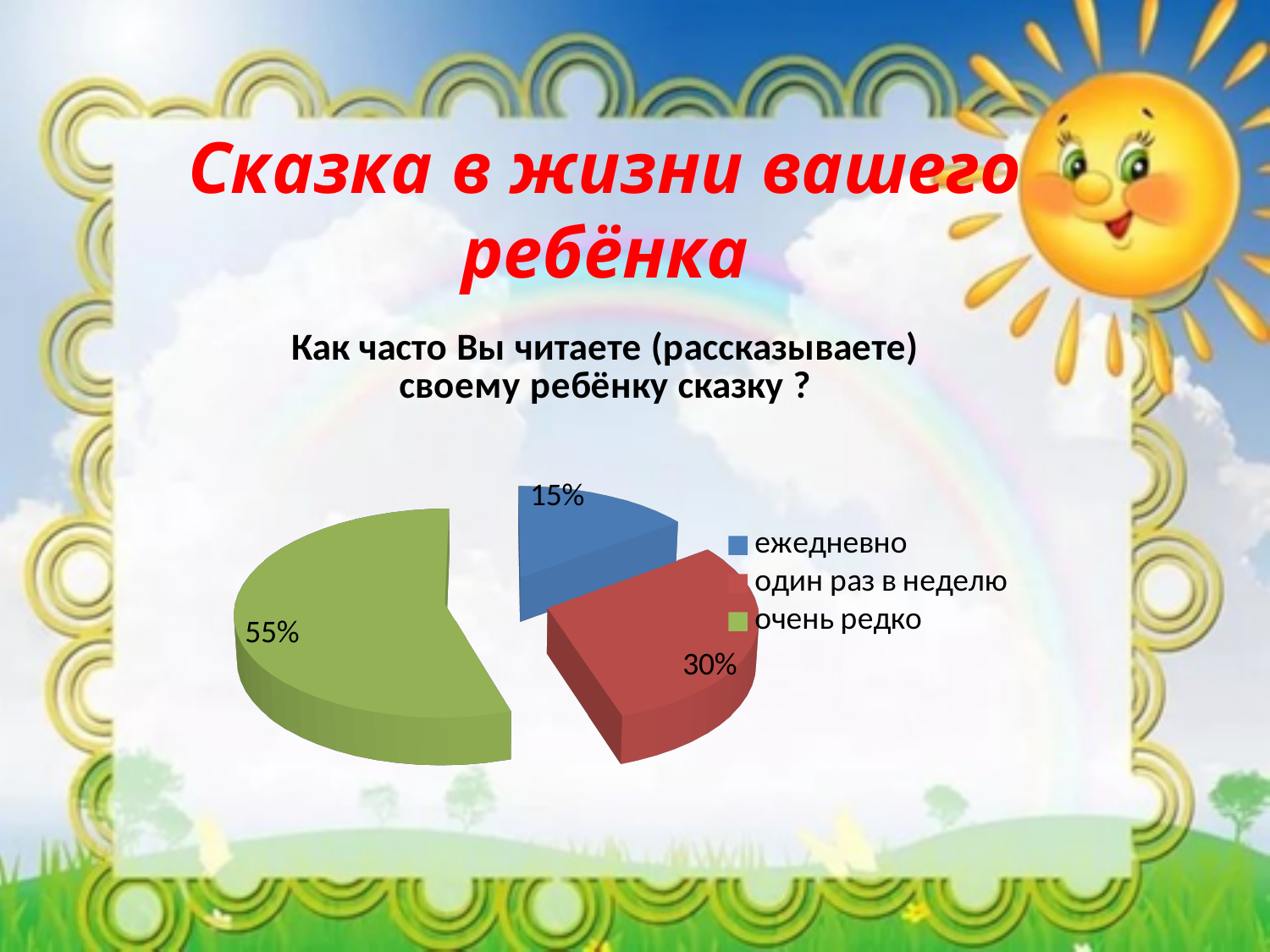
What share of the pie is labelled "очень редко"? 55% What share of the pie is labelled "один раз в неделю"? 30% What is the title of the chart? Как часто Вы читаете (рассказываете) своему ребёнку сказку ? What colour is the slice for "очень редко"? green Which is larger: the slice for "один раз в неделю" or the slice for "ежедневно"? один раз в неделю Which category has the smallest slice of the pie? ежедневно What share of the pie is labelled "ежедневно"? 15% Which category has the largest slice of the pie? очень редко What is the difference between the shares for "очень редко" and "один раз в неделю"? 25% What kind of chart is shown on the slide? pie chart What is the difference between the shares for "один раз в неделю" and "ежедневно"? 15% How many slices does the pie chart have? 3